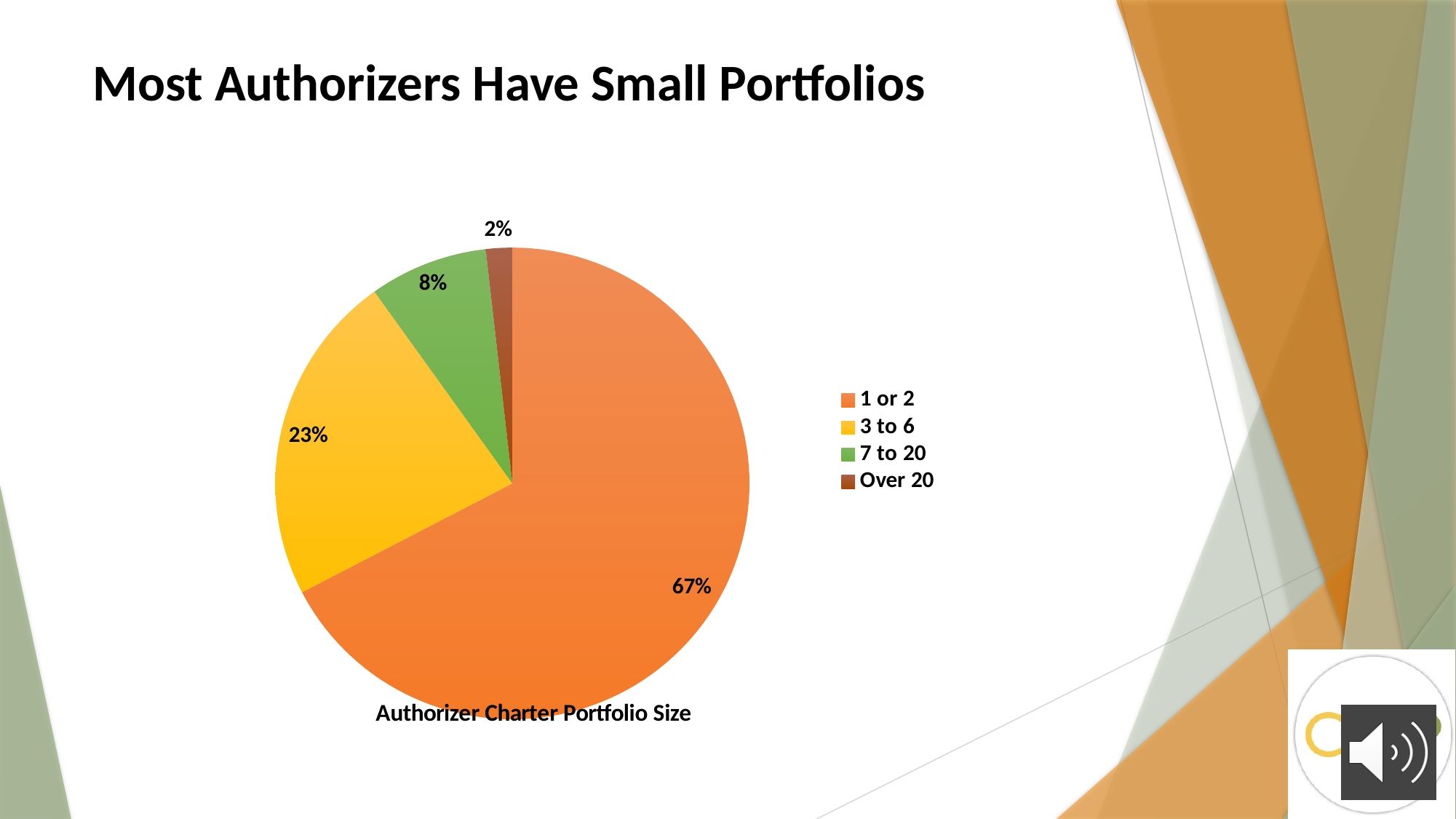
What share of the pie does the "Over 20" slice represent? 2% How many categories does the pie chart show? 4 What share of the pie does the "1 or 2" slice represent? 67% Which portfolio size category has the largest slice? 1 or 2 What kind of chart is shown on the slide? Pie chart Which is larger, the "3 to 6" slice or the "7 to 20" slice? 3 to 6 What share of the pie does the "7 to 20" slice represent? 8% Which portfolio size category has the smallest slice? Over 20 What is the title of the chart below the pie? Authorizer Charter Portfolio Size What colour is the "7 to 20" slice? Green What is the difference in percentage points between the "1 or 2" slice and the "3 to 6" slice? 44